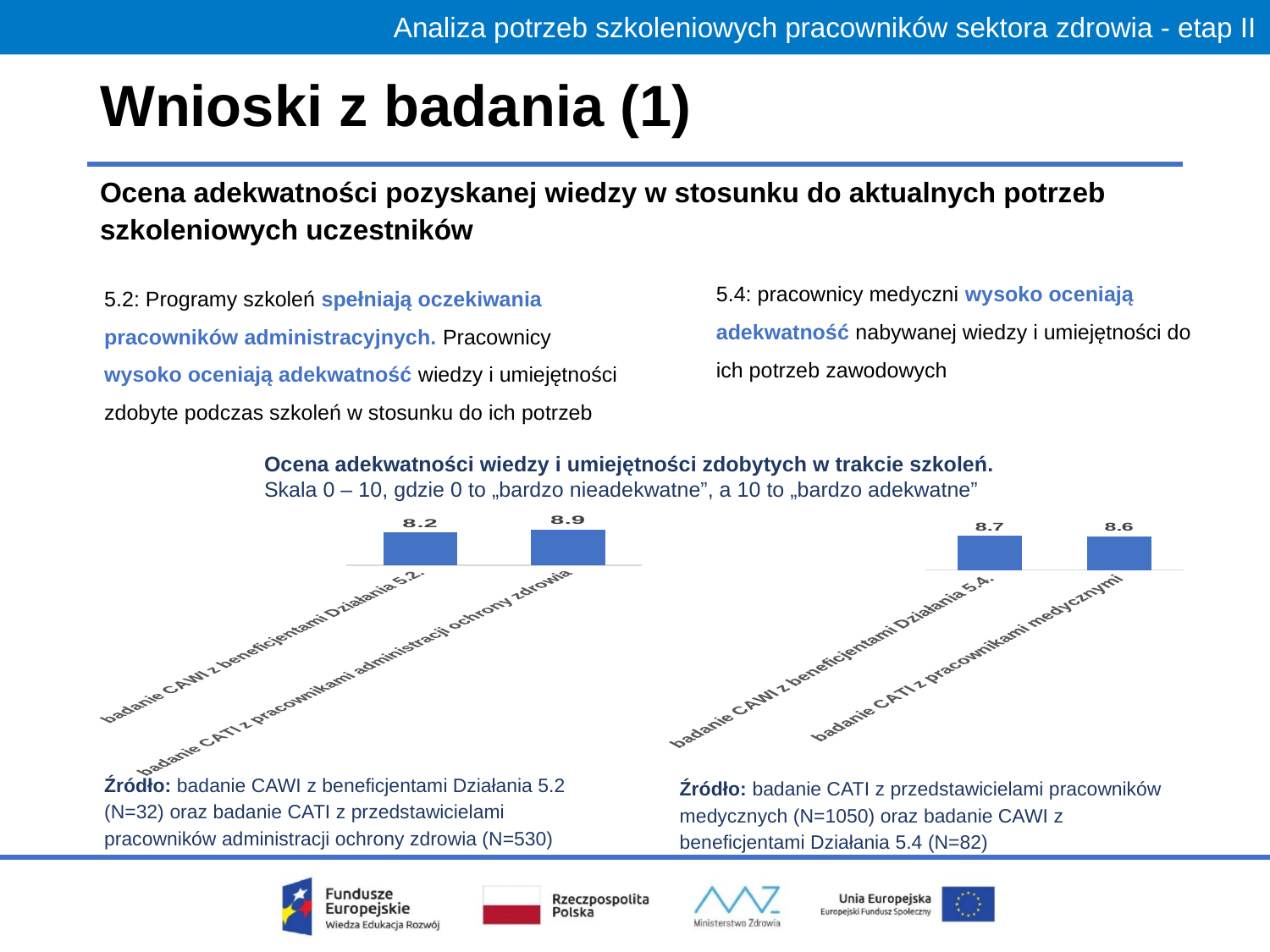
In the right chart, what is the value for 'badanie CATI z pracownikami medycznymi'? 8.6 In the left chart, what is the value for 'badanie CAWI z beneficjentami Działania 5.2.'? 8.2 In the left chart, what is the difference between the two bars' values? 0.7 In the right chart, which category has the lowest value? badanie CATI z pracownikami medycznymi What scale is used for the values shown in the two charts, according to the text above them? 0 – 10 In the right chart, what is the difference between the two bars' values? 0.1 In the left chart, which category has the highest value? badanie CATI z pracownikami administracji ochrony zdrowia In the left chart, how many bars are plotted? 2 In the left chart, what is the value for 'badanie CATI z pracownikami administracji ochrony zdrowia'? 8.9 What type of chart is the right chart? Bar chart In the right chart, what is the value for 'badanie CAWI z beneficjentami Działania 5.4.'? 8.7 Which is larger: the value for 'badanie CAWI z beneficjentami Działania 5.2.' in the left chart or the value for 'badanie CAWI z beneficjentami Działania 5.4.' in the right chart? badanie CAWI z beneficjentami Działania 5.4.